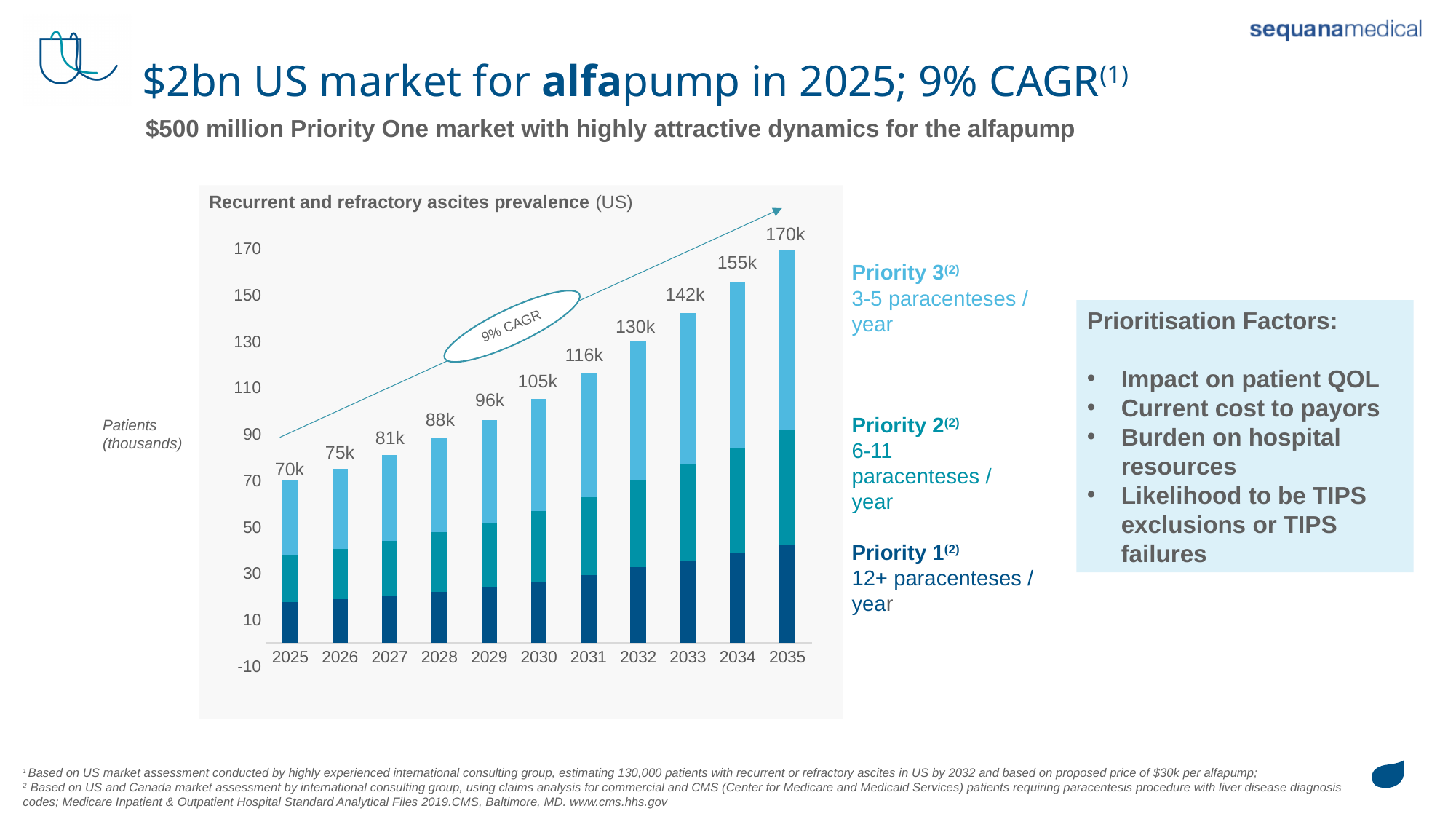
What is the total value shown for 2025? 70k What is the total value shown for 2032? 130k Do the total values rise or fall from 2025 to 2035? Rise What is the total value shown for 2035? 170k What growth rate is labelled on the arrow across the chart? 9% CAGR Which year has the highest total value? 2035 Which year has the lowest total value? 2025 What is the difference between the total for 2035 and the total for 2025? 100k Which is larger, the total for 2029 or the total for 2031? 2031 What kind of chart is shown on the slide? Stacked bar chart How many years are shown on the x axis? 11 Is the Priority 1 value for 2025 greater or less than 30? less